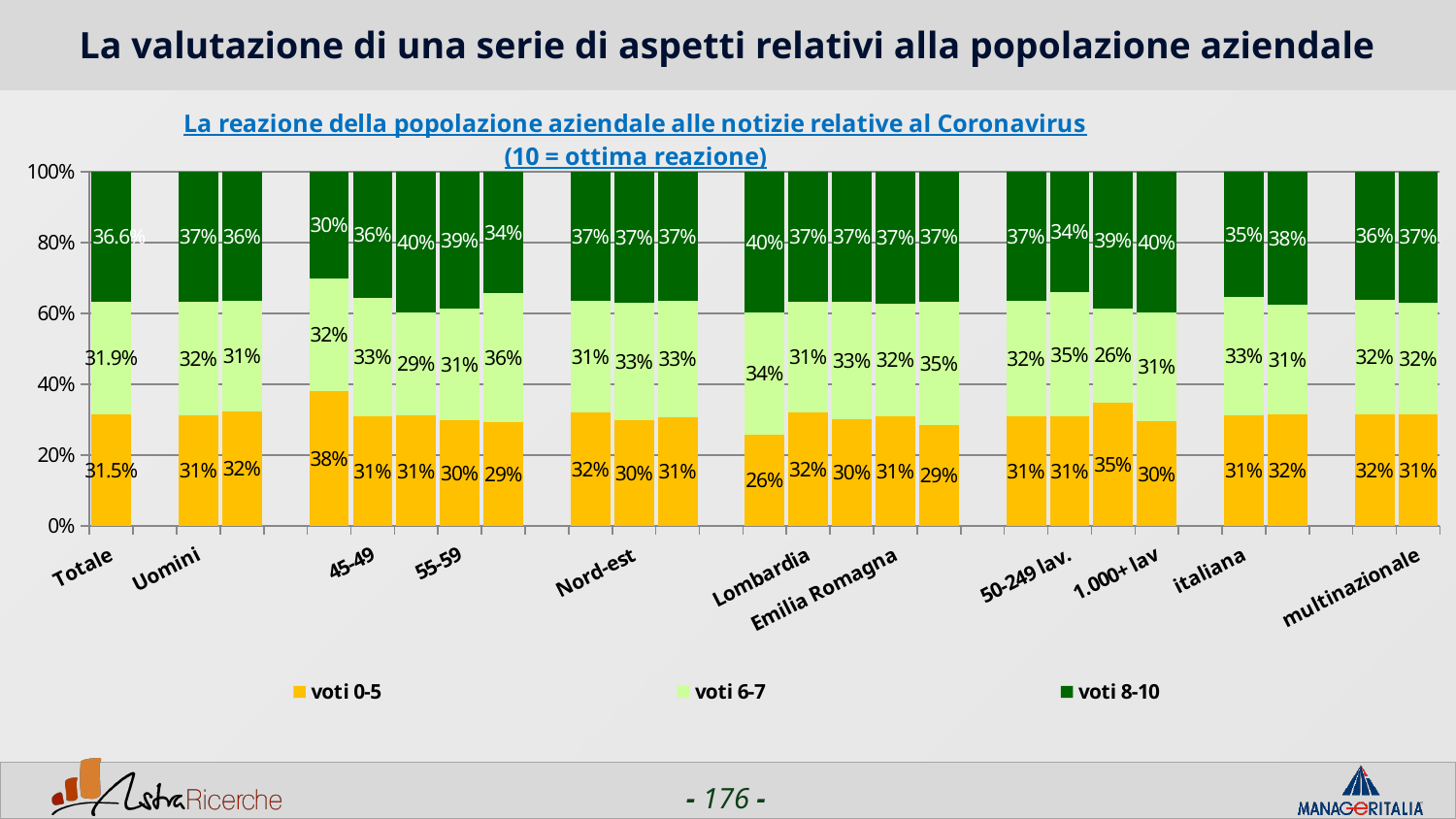
What is the value of 'voti 6-7' for Totale? 31.9% What is the value of 'voti 8-10' for multinazionale? 37% What is the difference between 'voti 8-10' and 'voti 0-5' for Totale? 5.1% How many series does the legend list? 3 What type of chart is shown on the slide? stacked bar chart What is the value of 'voti 0-5' for Totale? 31.5% For Totale, which is larger: 'voti 8-10' or 'voti 0-5'? voti 8-10 What are the three series named in the legend? voti 0-5, voti 6-7, voti 8-10 What is the value of 'voti 8-10' for Totale? 36.6% What is the value of 'voti 8-10' for Uomini? 37% What is the value of 'voti 6-7' for italiana? 33% What is the value of 'voti 0-5' for Uomini? 31%